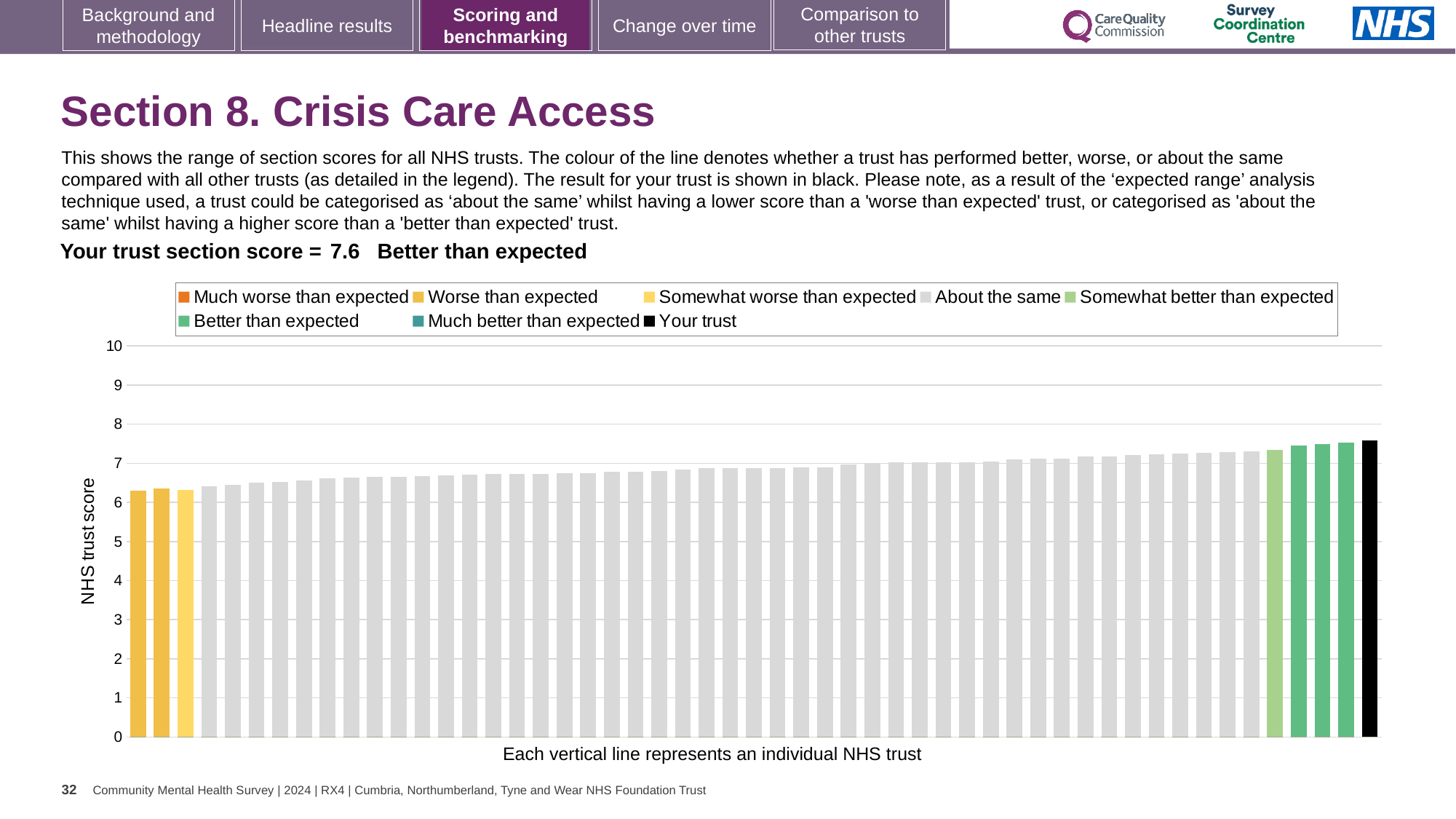
Which performance category is your trust placed in for Section 8? Better than expected How many entries does the chart legend list? 8 How many bars are coloured as 'Worse than expected' (yellow)? 2 What is the label on the y axis of the chart? NHS trust score Is the value of the leftmost bar greater or less than 6? greater Is the value of the tallest bar greater or less than 8? less What is the section score for your trust shown on the slide? 7.6 Is the value of the leftmost (lowest) bar greater or less than 7? less How many bars are coloured as 'Better than expected' (green)? 3 Do the bar values rise or fall moving from left to right along the x axis? Rise What kind of chart is shown on the slide? Bar chart